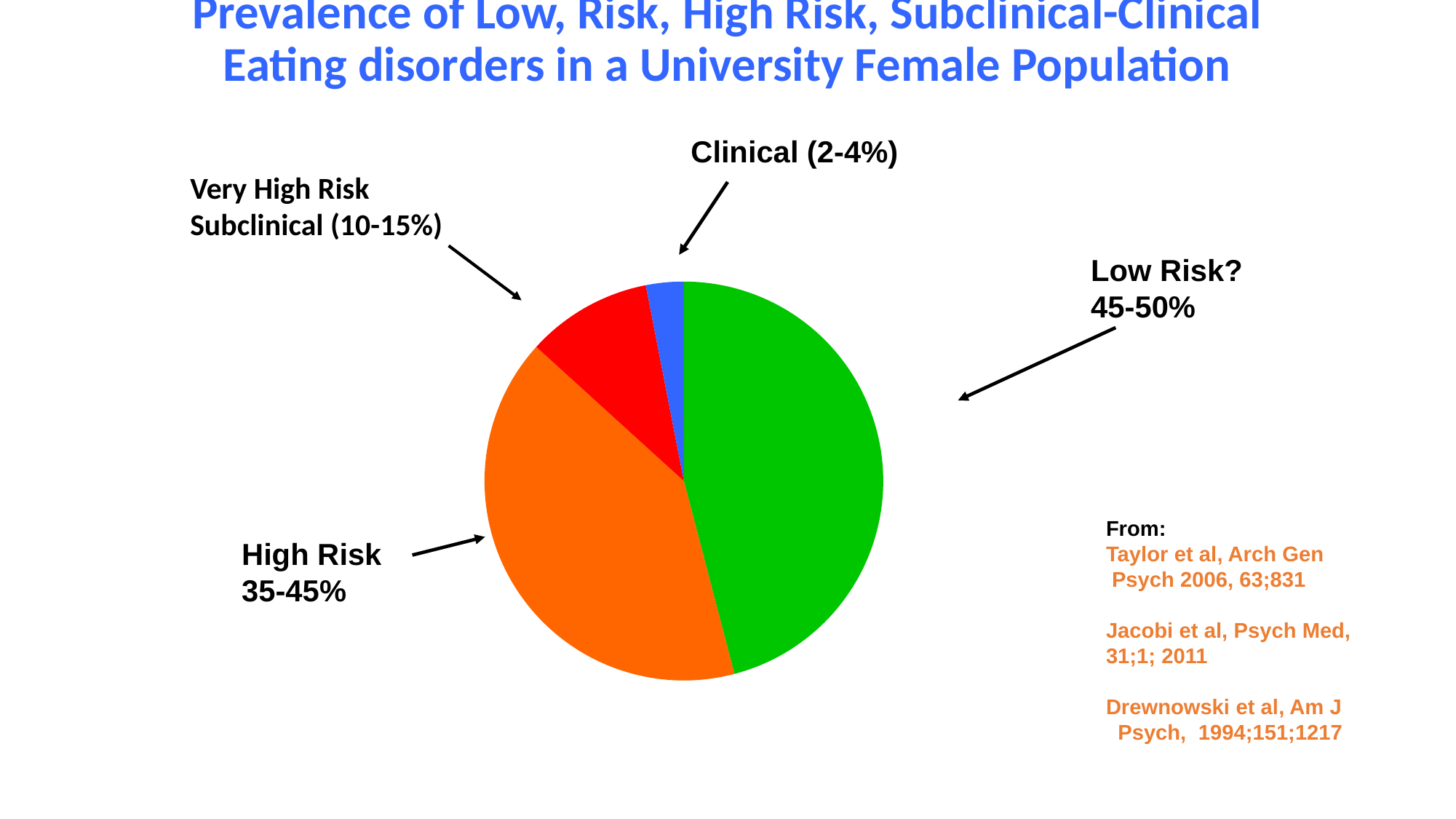
What prevalence range is given for the Clinical slice? 2-4% How many slices does the pie chart have? 4 What colour is the High Risk slice of the pie? orange What prevalence range is given for the High Risk slice? 35-45% Which category has the smallest slice of the pie? Clinical Which slice is larger, High Risk or Very High Risk Subclinical? High Risk Which slice is larger, Clinical or Very High Risk Subclinical? Very High Risk Subclinical What kind of chart is shown on the slide? pie chart What prevalence range is given for the Very High Risk Subclinical slice? 10-15% What prevalence range is given for the Low Risk slice? 45-50% Which category has the largest slice of the pie? Low Risk What colour is the Clinical slice of the pie? blue